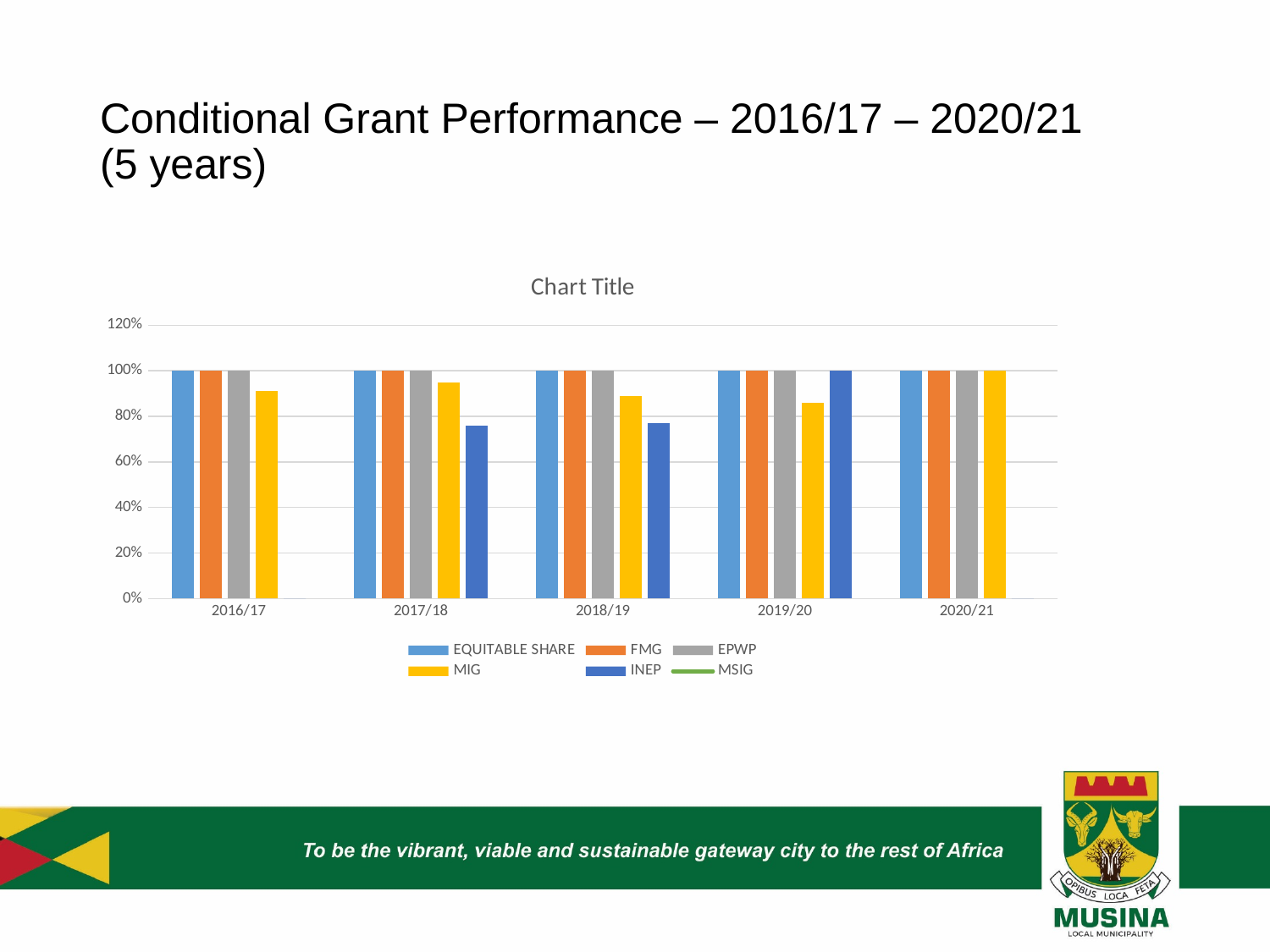
What is the title shown above the chart? Chart Title What kind of chart is shown on the slide? Bar chart What is the value for INEP in 2019/20? 100% Is the value for MIG in 2017/18 greater or less than 100%? less How many financial years are shown on the x axis of the chart? 5 How many series does the chart legend list? 6 What is the value for MIG in 2020/21? 100% Is the value for MIG in 2019/20 greater or less than 80%? greater In 2017/18, which is larger, the value for MIG or the value for INEP? MIG Is the value for INEP in 2017/18 greater or less than 80%? less What is the value for EQUITABLE SHARE in 2016/17? 100% Which series has the lowest value in 2018/19? INEP